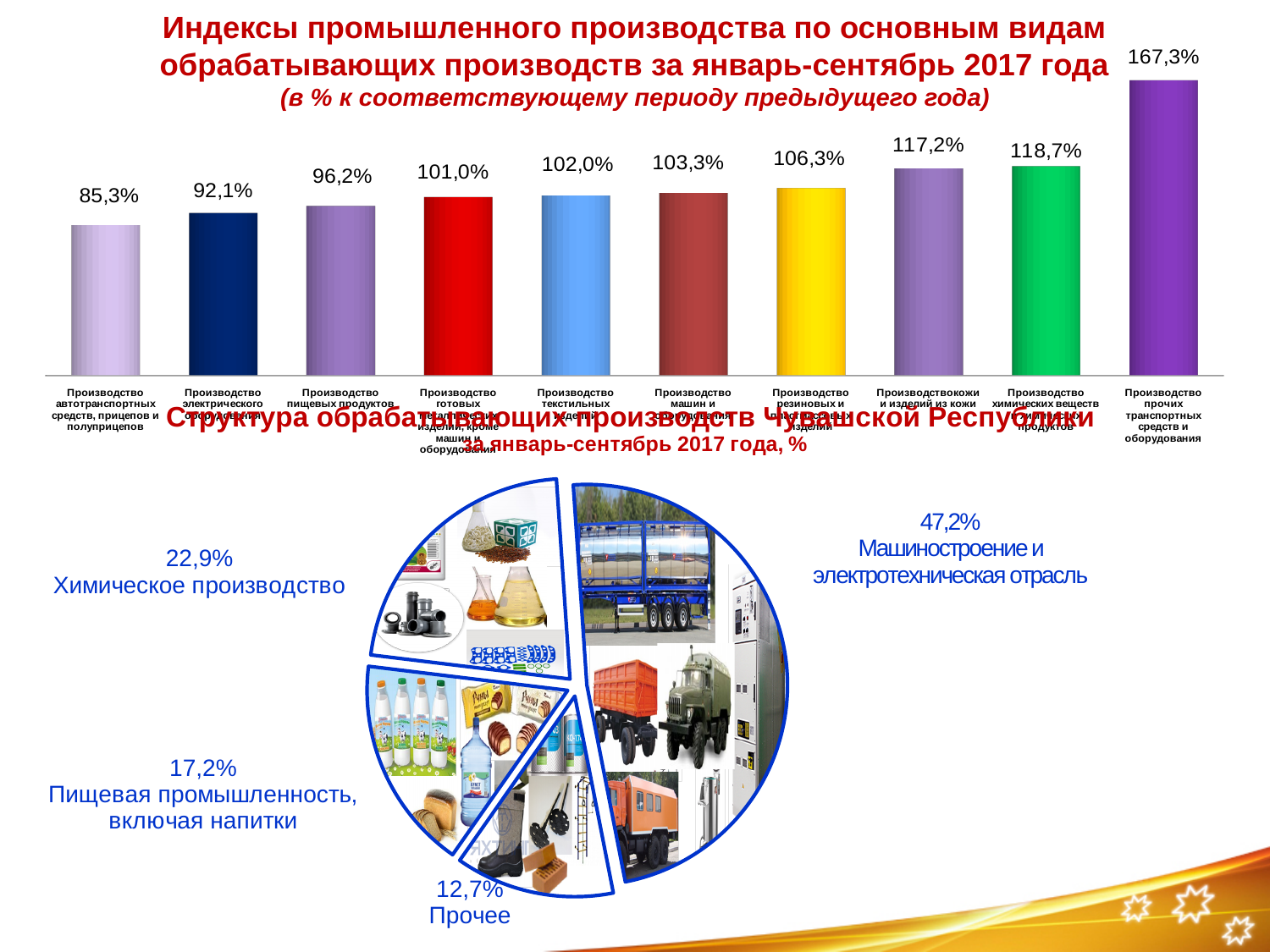
In the top bar chart, how many bars are shown? 10 In the top bar chart, what is the value for 'Производство автотранспортных средств, прицепов и полуприцепов'? 85,3% In the top bar chart, which category has the lowest value? Производство автотранспортных средств, прицепов и полуприцепов In the bottom pie chart, what share does 'Машиностроение и электротехническая отрасль' have? 47,2% In the top bar chart, what is the value for 'Производство пищевых продуктов'? 96,2% In the top bar chart, what is the value for 'Производство текстильных изделий'? 102,0% In the top bar chart, do the values rise or fall from left to right? rise In the top bar chart, which category has the highest value? Производство прочих транспортных средств и оборудования In the bottom pie chart, which is larger: 'Химическое производство' or 'Пищевая промышленность, включая напитки'? Химическое производство What kind of chart is the top chart on the slide? bar chart In the top bar chart, what is the difference between the highest value (167,3%) and the lowest value (85,3%)? 82,0% In the bottom pie chart, how many slices are there? 4